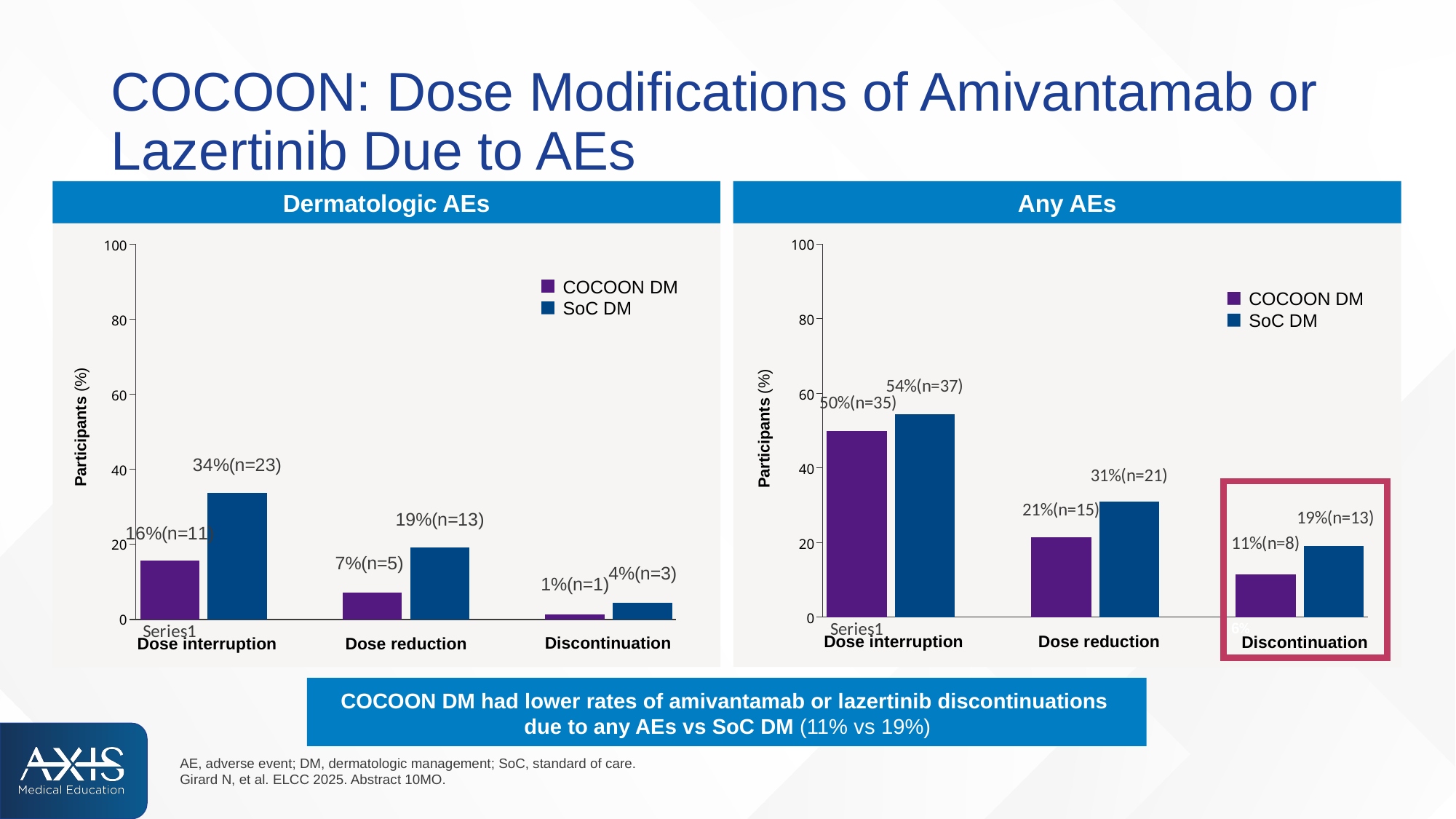
How many categories are shown on the x axis of the Dermatologic AEs chart? 3 In the Any AEs chart, what is the difference in percentage points between SoC DM and COCOON DM for Discontinuation? 8 In the Any AEs chart, what is the value for COCOON DM for Discontinuation? 11%(n=8) In the Dermatologic AEs chart, what is the value for SoC DM for Dose interruption? 34%(n=23) In the Dermatologic AEs chart, which category has the lowest COCOON DM value? Discontinuation In the Dermatologic AEs chart, which is larger for Dose interruption: COCOON DM or SoC DM? SoC DM In the Any AEs chart, is the COCOON DM value for Dose interruption greater or less than 40? greater How many series does the legend of the Any AEs chart list? 2 In the Dermatologic AEs chart, what is the value for COCOON DM for Dose reduction? 7%(n=5) In the Any AEs chart, which category has the highest SoC DM value? Dose interruption In the Any AEs chart, what is the value for SoC DM for Dose reduction? 31%(n=21) What kind of chart is the Dermatologic AEs chart? Bar chart